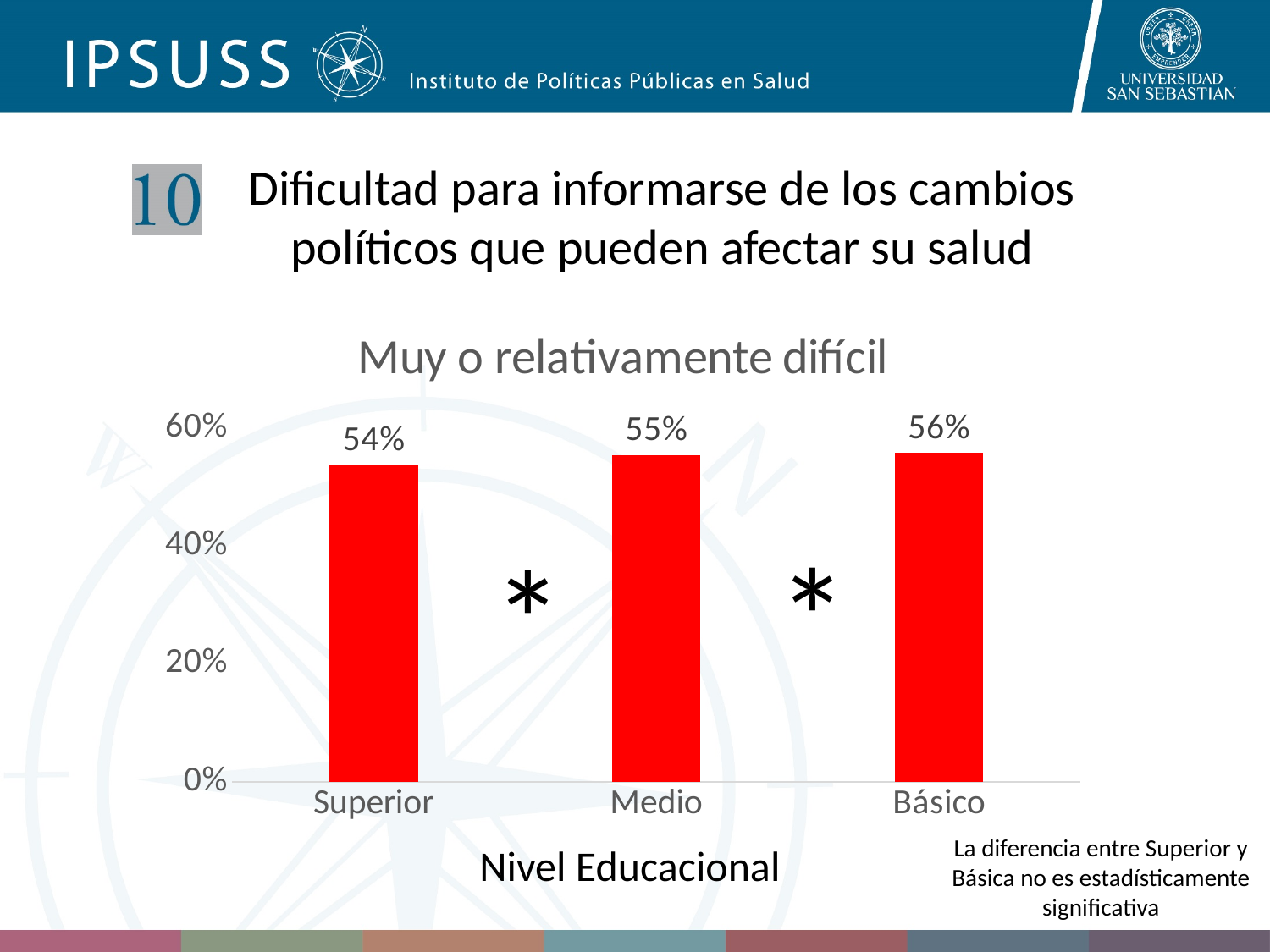
What kind of chart is shown? bar chart Do the values rise or fall from Superior to Básico? rise What is the difference between the values for Medio and Superior? 1% What is the difference between the values for Básico and Superior? 2% Which educational level has the highest value? Básico Which educational level has the lowest value? Superior Is the value for Medio greater or less than 40%? greater What is the title of the chart? Muy o relativamente difícil What is the value for Medio? 55% How many educational levels are shown on the chart? 3 What is the value for Superior? 54% What is the value for Básico? 56%